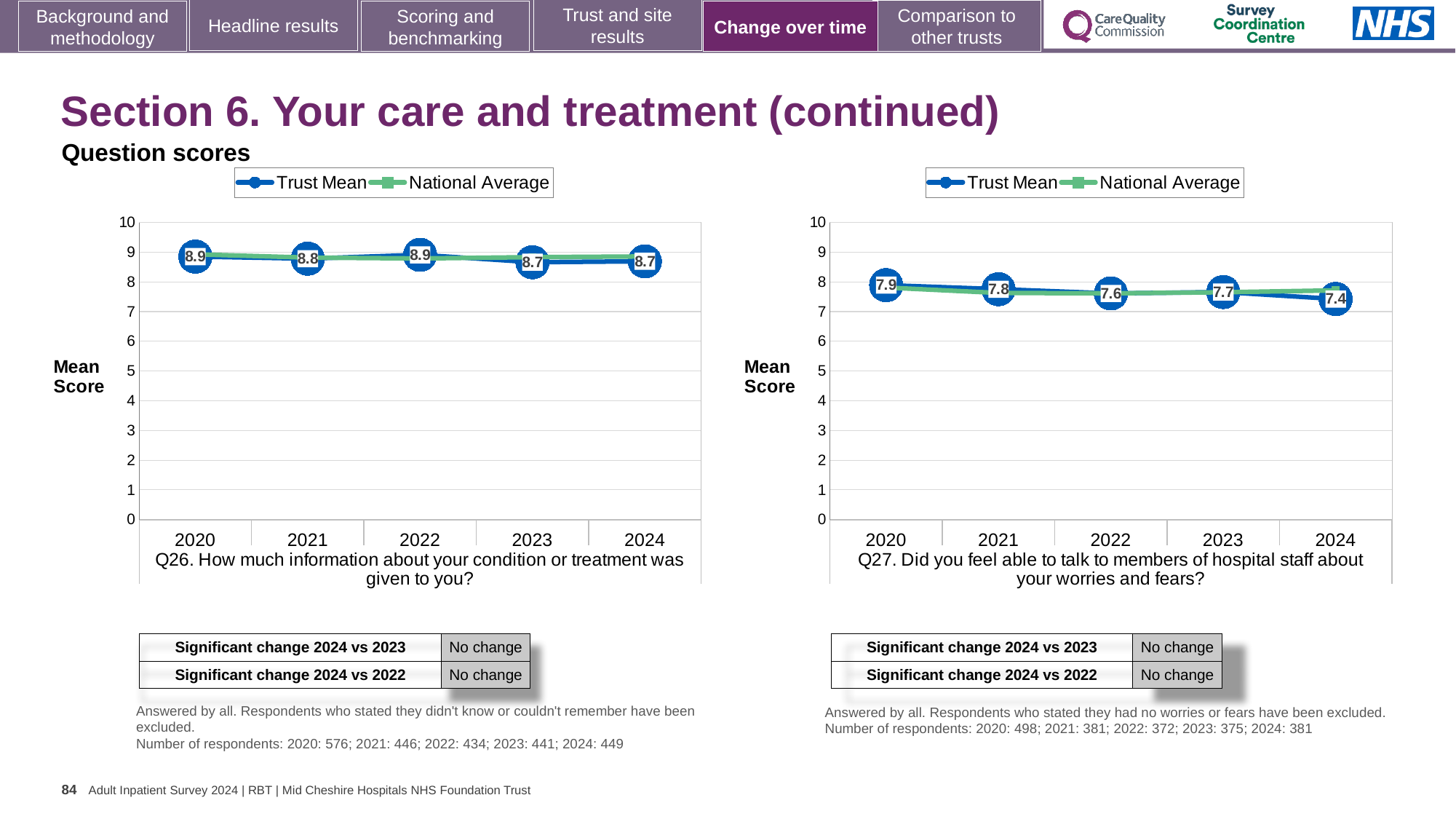
How many series does the legend of the Q26 chart (left) list? 2 On the Q27 chart (right), which year has the lowest Trust Mean score? 2024 On the Q27 chart (right), what is the Trust Mean score for 2024? 7.4 On the Q27 chart (right), which year has the highest Trust Mean score? 2020 On the Q26 chart (left), what is the Trust Mean score for 2020? 8.9 On the Q26 chart (left), what is the Trust Mean score for 2024? 8.7 On the Q27 chart (right), what is the Trust Mean score for 2022? 7.6 On the Q27 chart (right), what is the difference between the Trust Mean scores for 2020 and 2024? 0.5 How many years are plotted on the x axis of the Q27 chart (right)? 5 On the Q26 chart (left), is the Trust Mean score for 2021 larger or smaller than the score for 2022? smaller On the Q26 chart (left), what is the difference between the Trust Mean scores for 2022 and 2023? 0.2 What kind of chart is the Q27 chart (right)? line chart